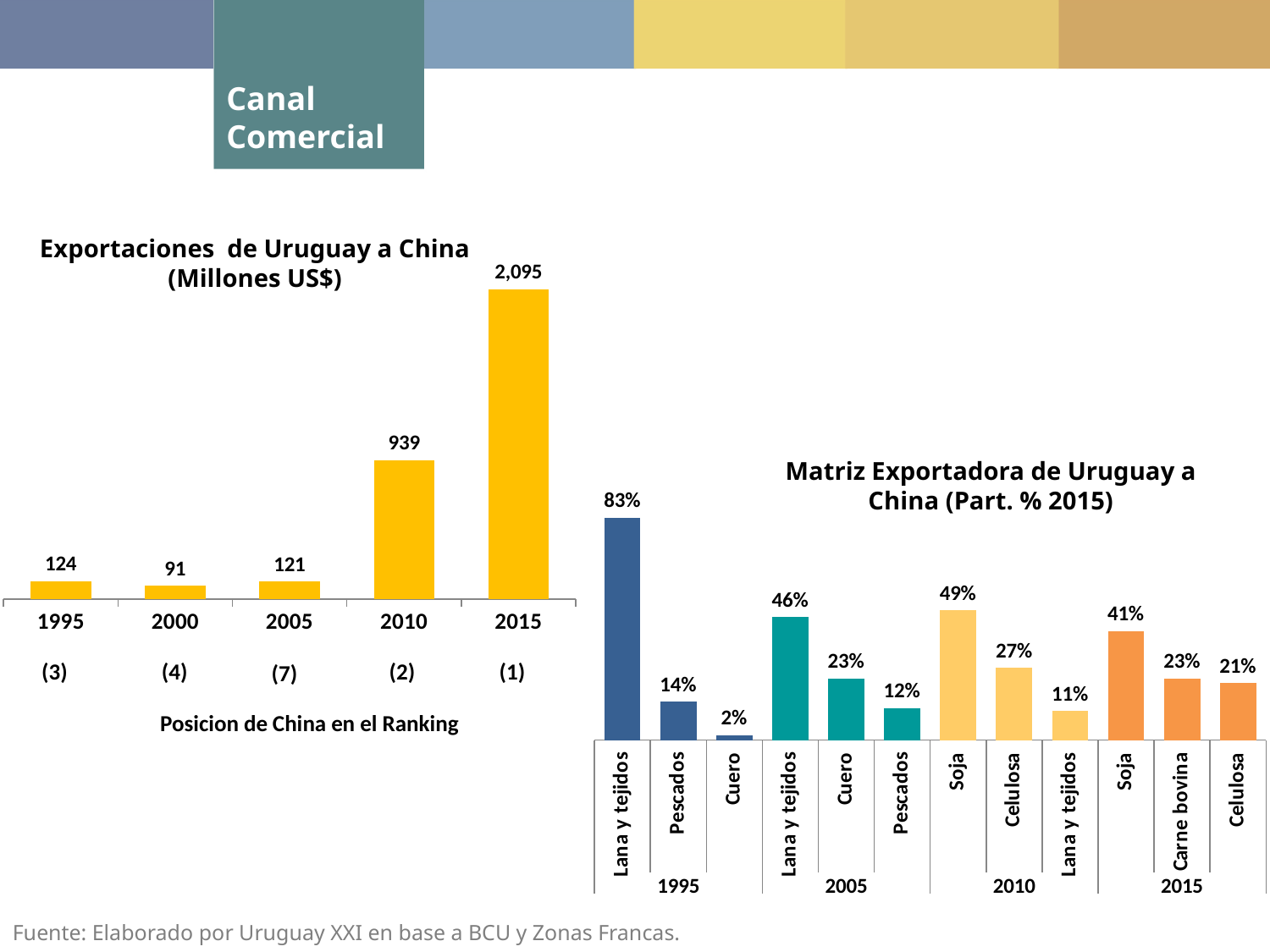
What kind of chart is 'Exportaciones de Uruguay a China (Millones US$)'? Bar chart In the chart 'Exportaciones de Uruguay a China (Millones US$)', how many years are shown on the x axis? 5 In the chart 'Matriz Exportadora de Uruguay a China (Part. % 2015)', how many bars are plotted in total? 12 In the chart 'Matriz Exportadora de Uruguay a China (Part. % 2015)', what is the share for Soja in 2015? 41% In the chart 'Exportaciones de Uruguay a China (Millones US$)', what is the value for 2010? 939 In the chart 'Matriz Exportadora de Uruguay a China (Part. % 2015)', what is the difference between Celulosa in 2010 and Celulosa in 2015? 6% In the chart 'Exportaciones de Uruguay a China (Millones US$)', which year has the highest value? 2015 In the chart 'Exportaciones de Uruguay a China (Millones US$)', what is the difference between the values for 2015 and 2010? 1,156 In the chart 'Matriz Exportadora de Uruguay a China (Part. % 2015)', what is the share for Lana y tejidos in 1995? 83% In the chart 'Matriz Exportadora de Uruguay a China (Part. % 2015)', which is larger: Soja in 2010 or Soja in 2015? Soja in 2010 In the chart 'Matriz Exportadora de Uruguay a China (Part. % 2015)', which bar has the lowest value? Cuero (1995) In the chart 'Exportaciones de Uruguay a China (Millones US$)', which year has the lowest value? 2000